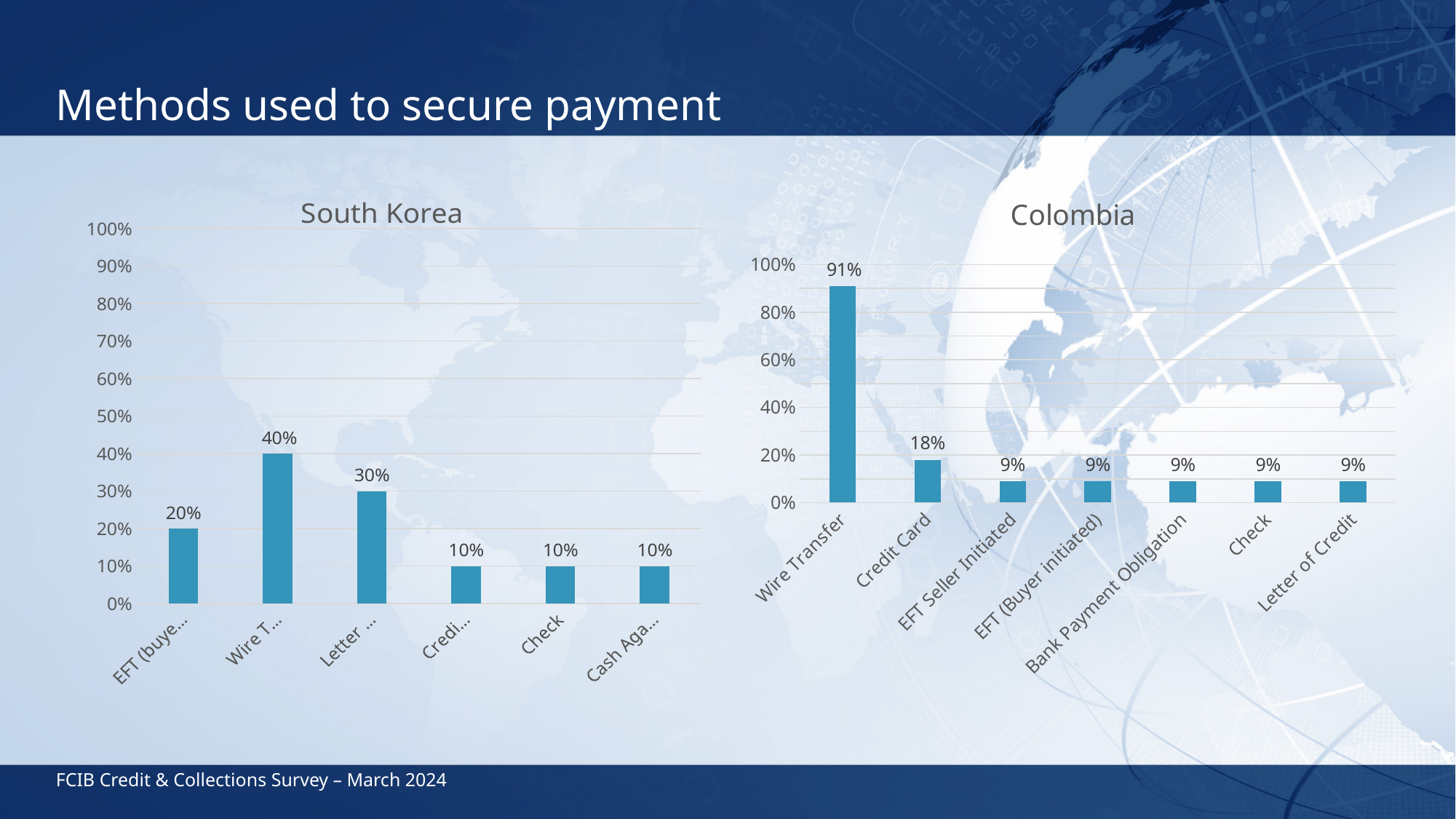
In the Colombia chart, which category has the highest value? Wire Transfer In the South Korea chart, what is the value for Check? 10% What is the highest value shown in the South Korea chart? 40% In the Colombia chart, what is the value for Bank Payment Obligation? 9% How many categories are shown in the Colombia chart? 7 What type of chart is the South Korea chart? Bar chart What is the title of the chart on the right side of the slide? Colombia How many categories are shown in the South Korea chart? 6 In the Colombia chart, which is larger, Credit Card or Letter of Credit? Credit Card In the Colombia chart, what is the difference between Wire Transfer and Credit Card? 73% In the Colombia chart, what is the value for Wire Transfer? 91% In the Colombia chart, what is the value for Credit Card? 18%